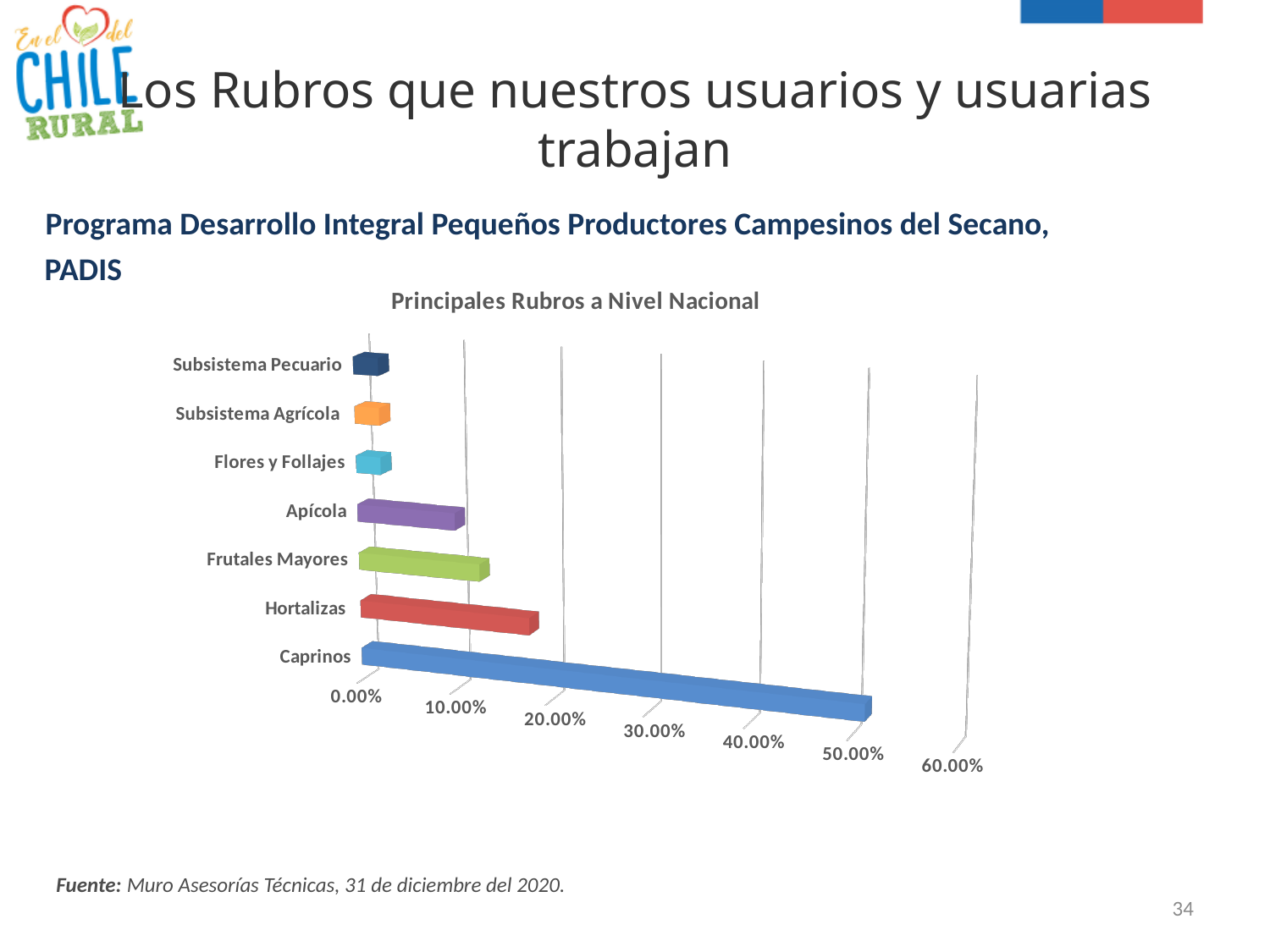
Is the value for Subsistema Pecuario greater or less than 10.00%? less Which is larger, the value for Apícola or the value for Flores y Follajes? Apícola What is the title of the chart? Principales Rubros a Nivel Nacional What kind of chart is shown on the slide? bar chart Is the value for Frutales Mayores greater or less than 20.00%? less Which is larger, the value for Caprinos or the value for Hortalizas? Caprinos Is the value for Hortalizas greater or less than 30.00%? less Which is larger, the value for Hortalizas or the value for Frutales Mayores? Hortalizas How many categories (rubros) are shown in the chart? 7 What is the highest tick value shown on the percentage axis? 60.00% Which category has the highest value in the chart? Caprinos